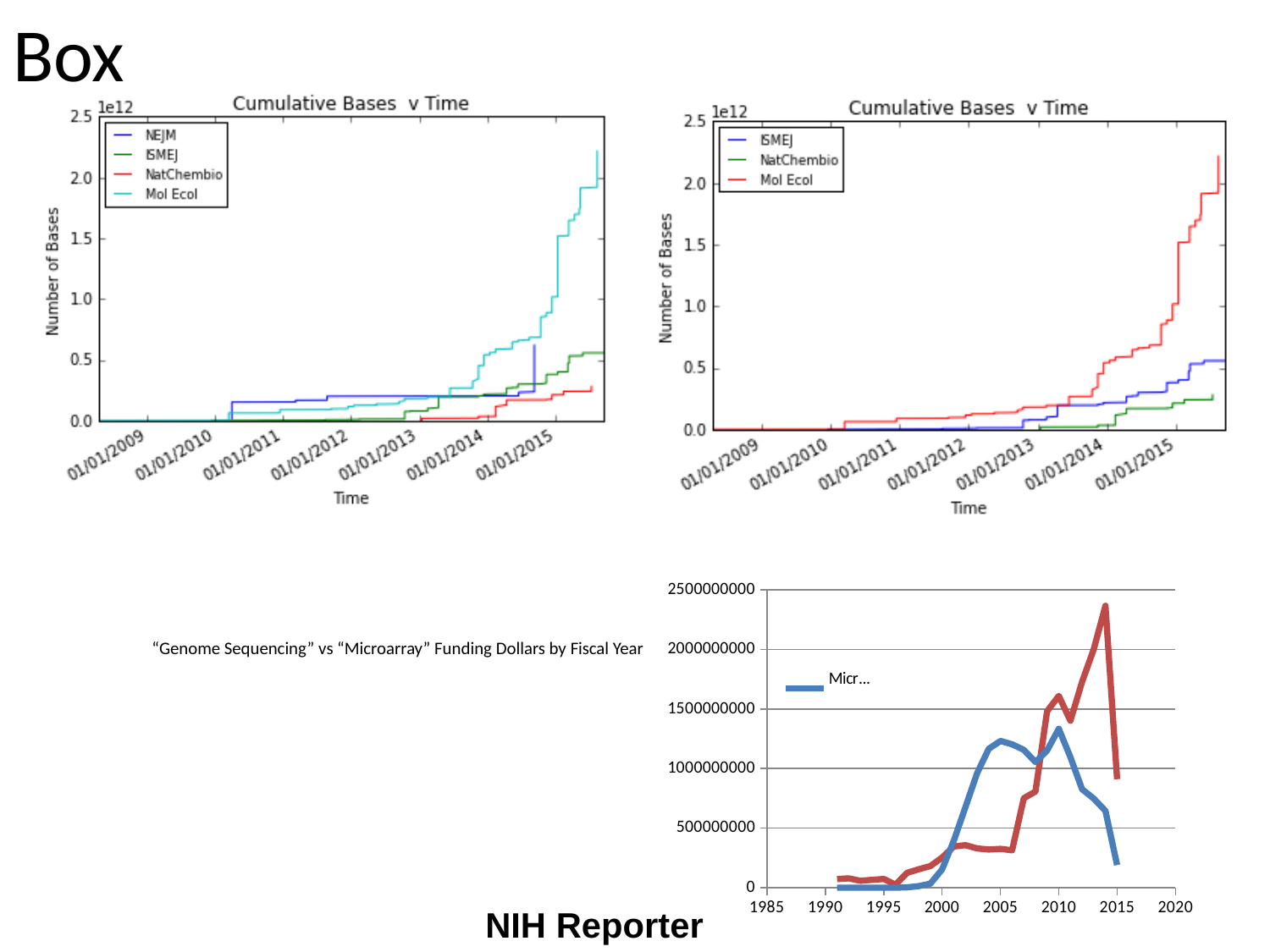
In the bottom-right funding chart, is the peak value of the red line greater or less than 2000000000? greater In the bottom-right funding chart, is the peak value of the blue line greater or less than 1500000000? less In the bottom-right funding chart, does the blue line rise or fall between 2010 and 2015? fall What kind of chart is the top-left 'Cumulative Bases v Time' chart? line chart What is the label of the y axis on the top-right 'Cumulative Bases v Time' chart? Number of Bases Which series is listed in the legend of the top-left 'Cumulative Bases v Time' chart but not in the top-right one? NEJM In the top-left 'Cumulative Bases v Time' chart, which series reaches the highest number of bases by the end of the time axis? Mol Ecol How many series does the legend of the top-right 'Cumulative Bases v Time' chart list? 3 How many series does the legend of the top-left 'Cumulative Bases v Time' chart list? 4 In the top-left 'Cumulative Bases v Time' chart, is the final value of NatChembio greater or less than 0.5 (x1e12)? less In the top-right 'Cumulative Bases v Time' chart, which series has the lowest cumulative bases at the end of the time axis? NatChembio